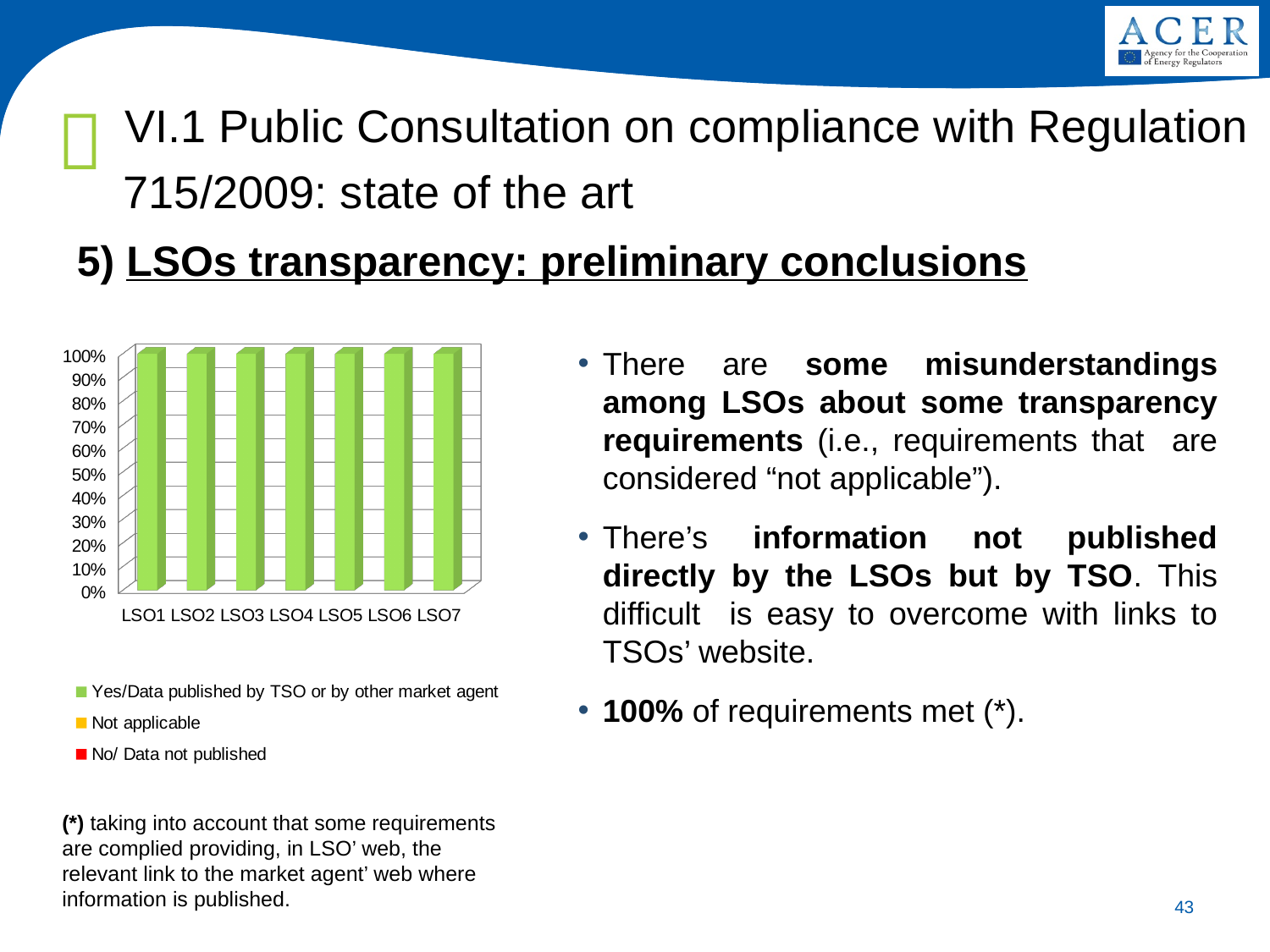
What is the total height of the stacked bar for LSO4? 100% How many LSO categories are shown on the x axis of the chart? 7 What is the value of the 'Yes/Data published by TSO or by other market agent' series for LSO1? 100% Is the value for LSO6 greater or less than 90%? greater What is the difference between the values for LSO2 and LSO5? 0% What kind of chart is shown on the slide? bar chart Do the bar values rise, fall, or stay the same from LSO1 to LSO7? stay the same Which legend entry is shown in green? Yes/Data published by TSO or by other market agent What is the value of the 'Yes/Data published by TSO or by other market agent' series for LSO7? 100% Which legend entry is shown in red? No/ Data not published Is the value for LSO3 greater or less than 50%? greater How many series does the chart's legend list? 3